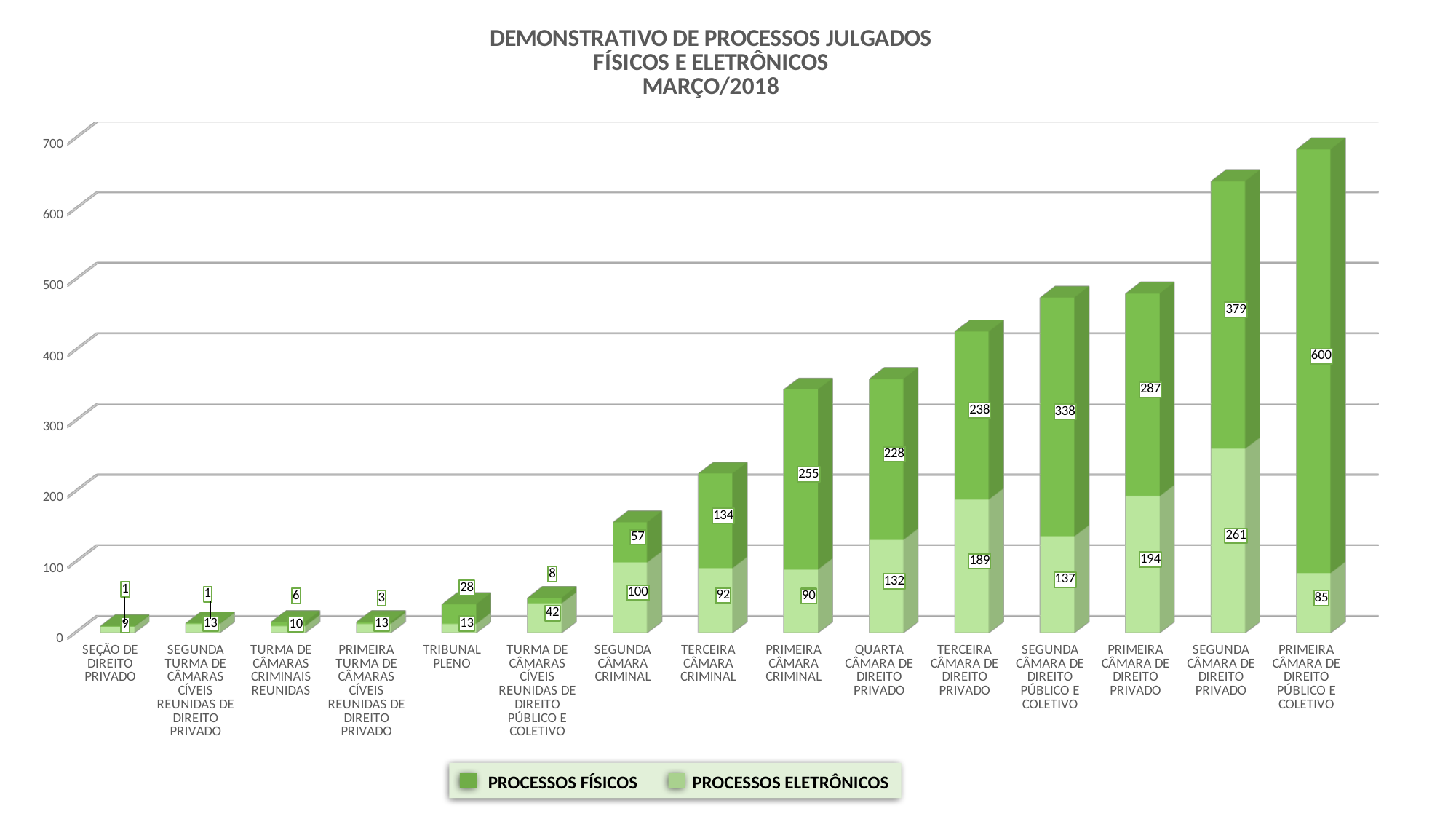
Which is larger for TERCEIRA CÂMARA CRIMINAL: PROCESSOS FÍSICOS or PROCESSOS ELETRÔNICOS? PROCESSOS FÍSICOS What is the total of the stacked bar for SEGUNDA CÂMARA DE DIREITO PRIVADO? 640 Which category has the lowest value of PROCESSOS ELETRÔNICOS? SEÇÃO DE DIREITO PRIVADO What is the title of the chart? DEMONSTRATIVO DE PROCESSOS JULGADOS FÍSICOS E ELETRÔNICOS MARÇO/2018 What is the value of PROCESSOS FÍSICOS for PRIMEIRA CÂMARA DE DIREITO PÚBLICO E COLETIVO? 600 What type of chart is shown on the slide? Stacked bar chart How many categories are shown on the x axis? 15 What is the value of PROCESSOS ELETRÔNICOS for SEGUNDA CÂMARA DE DIREITO PRIVADO? 261 Which category has the highest value of PROCESSOS FÍSICOS? PRIMEIRA CÂMARA DE DIREITO PÚBLICO E COLETIVO What is the value of PROCESSOS FÍSICOS for TRIBUNAL PLENO? 28 What is the difference between PROCESSOS FÍSICOS and PROCESSOS ELETRÔNICOS for SEGUNDA CÂMARA DE DIREITO PÚBLICO E COLETIVO? 201 How many series does the legend list? 2